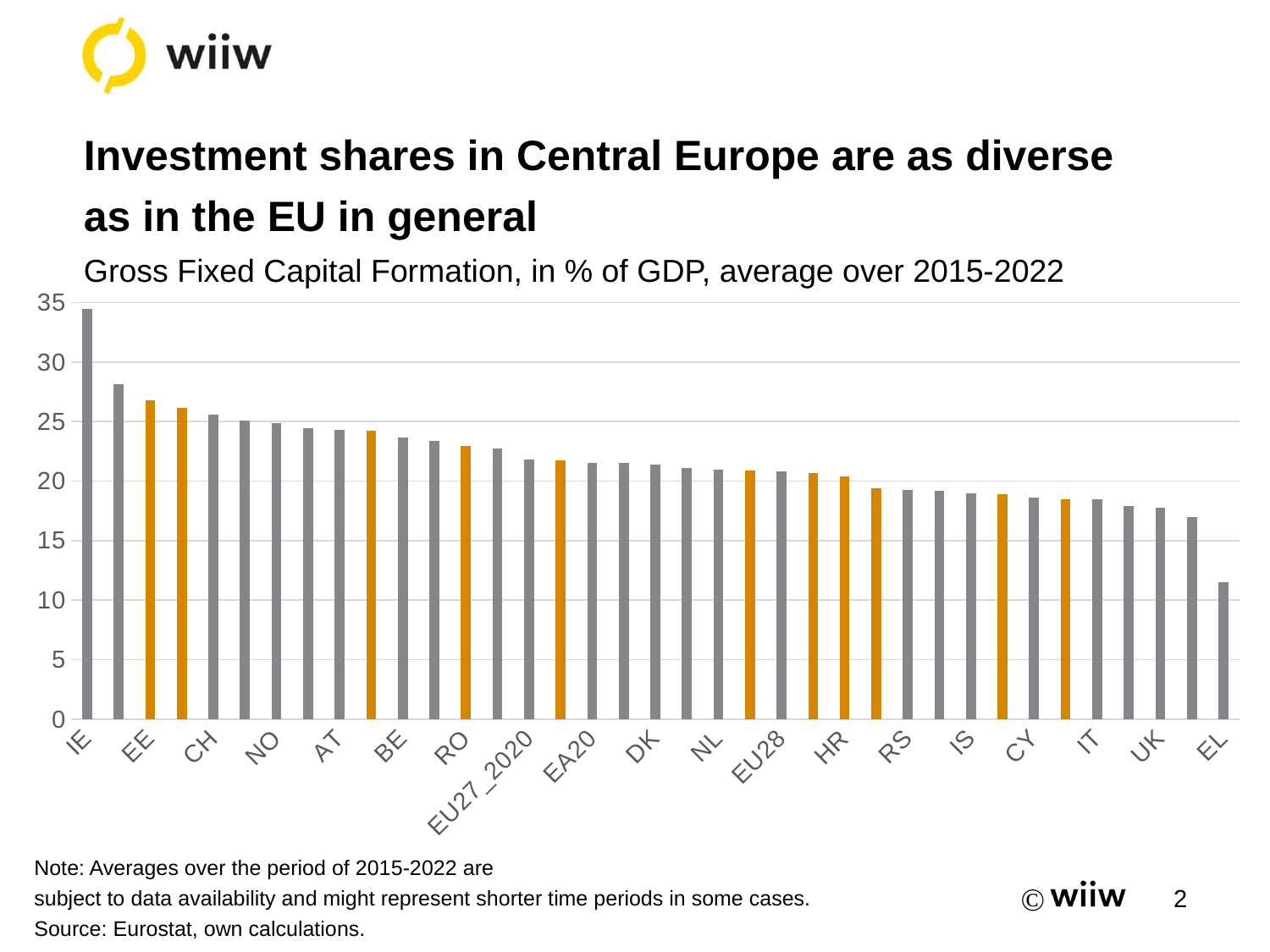
Is the value for IE greater or less than 30? greater How many category labels are shown on the x axis? 19 Which country has the lowest Gross Fixed Capital Formation share of GDP? EL Which has a larger value, CH or HR? CH Is the value for EL greater or less than 15? less Is the value for EE greater or less than 25? greater Which country has the highest Gross Fixed Capital Formation share of GDP? IE Do the bar values rise or fall from left to right along the x axis? fall What kind of chart is shown on the slide? bar chart What is the subtitle describing the measure plotted in the chart? Gross Fixed Capital Formation, in % of GDP, average over 2015-2022